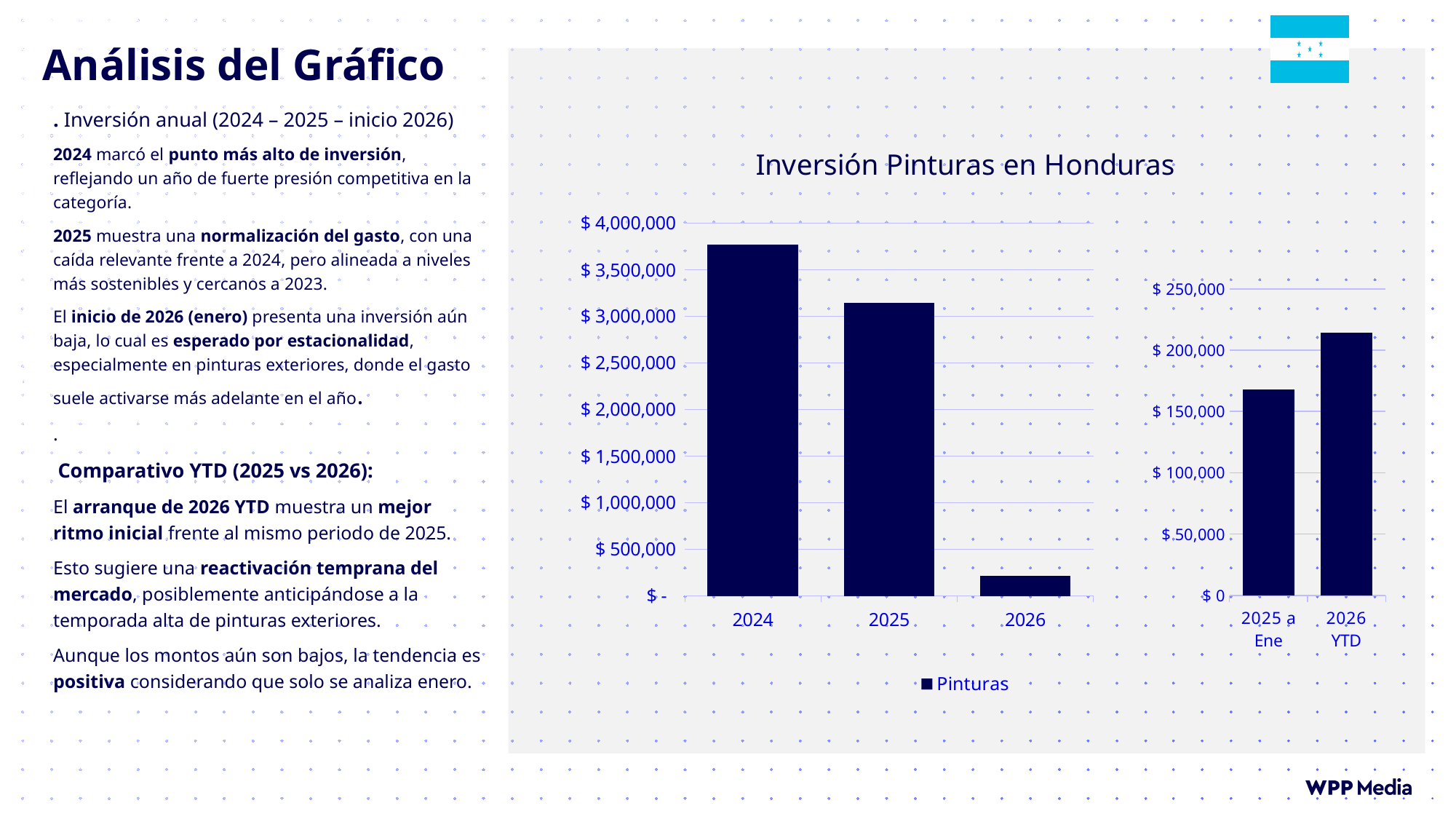
What kind of chart is the chart titled 'Inversión Pinturas en Honduras'? bar chart How many categories are shown on the x axis of the chart titled 'Inversión Pinturas en Honduras'? 3 In the smaller chart on the right of the slide, is the value for '2025 a Ene' greater or less than $ 150,000? greater In the chart titled 'Inversión Pinturas en Honduras', which year has the highest investment? 2024 In the chart titled 'Inversión Pinturas en Honduras', do the values rise or fall from 2024 to 2026? fall In the chart titled 'Inversión Pinturas en Honduras', which year has the lowest investment? 2026 In the chart titled 'Inversión Pinturas en Honduras', is the value for 2026 greater or less than $ 500,000? less How many series does the legend of the chart titled 'Inversión Pinturas en Honduras' list? 1 In the chart titled 'Inversión Pinturas en Honduras', is the value for 2024 greater or less than $ 3,500,000? greater In the smaller chart on the right of the slide, which is larger: '2025 a Ene' or '2026 YTD'? 2026 YTD